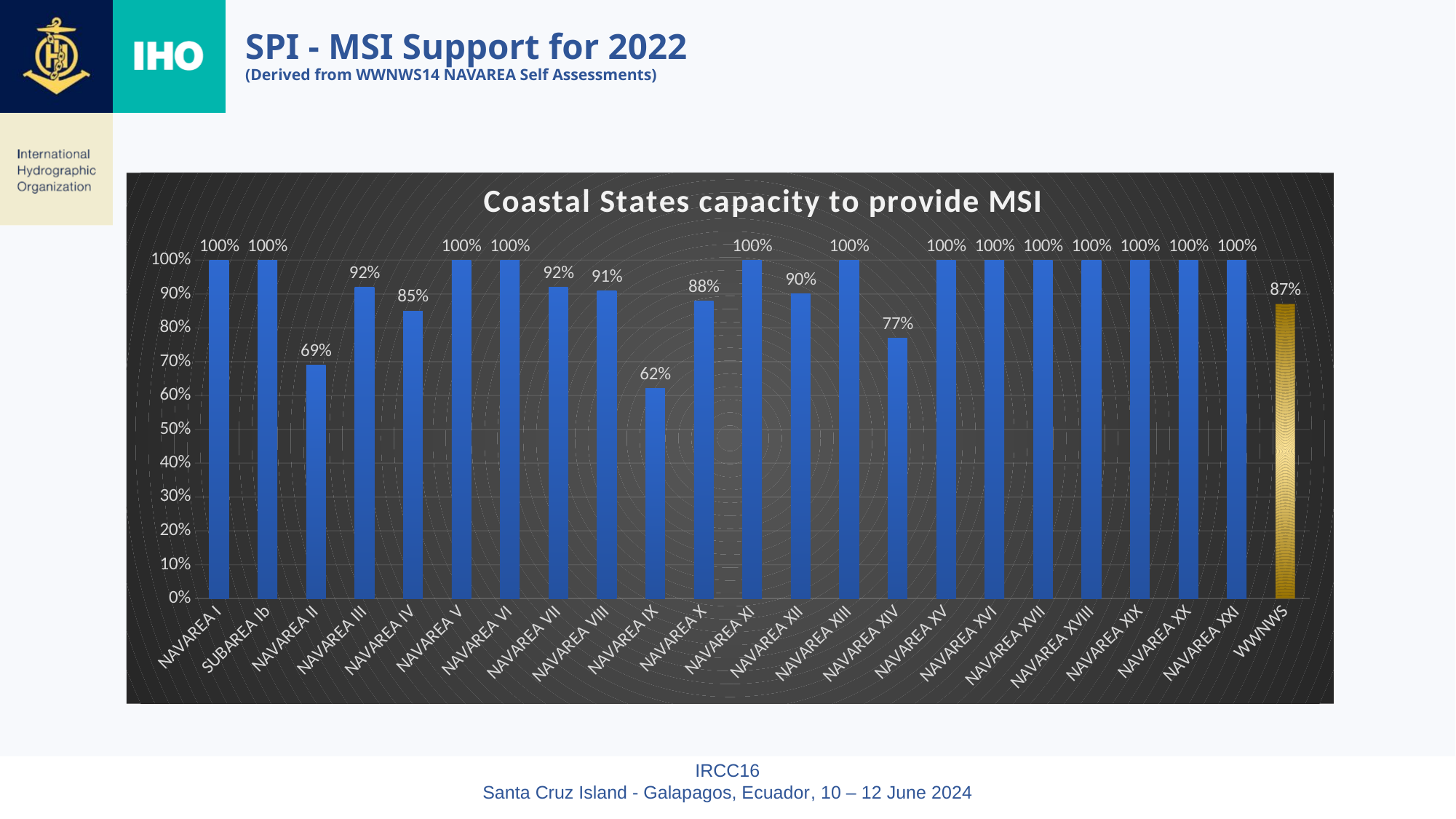
What is the difference between the values for NAVAREA XII and NAVAREA IX? 28% Which category has the lowest value in the chart? NAVAREA IX What is the value for NAVAREA XIV? 77% What is the value for NAVAREA IX in the Coastal States capacity to provide MSI chart? 62% What is the title of the chart? Coastal States capacity to provide MSI What is the value for NAVAREA II? 69% What is the value for WWNWS in the chart? 87% Which is larger, the value for NAVAREA X or the value for NAVAREA XIV? NAVAREA X Is the value for NAVAREA VIII greater or less than 80%? greater What is the difference between the values for NAVAREA III and NAVAREA IV? 7% How many categories are shown on the x axis of the chart? 23 What kind of chart is shown on the slide? Bar chart